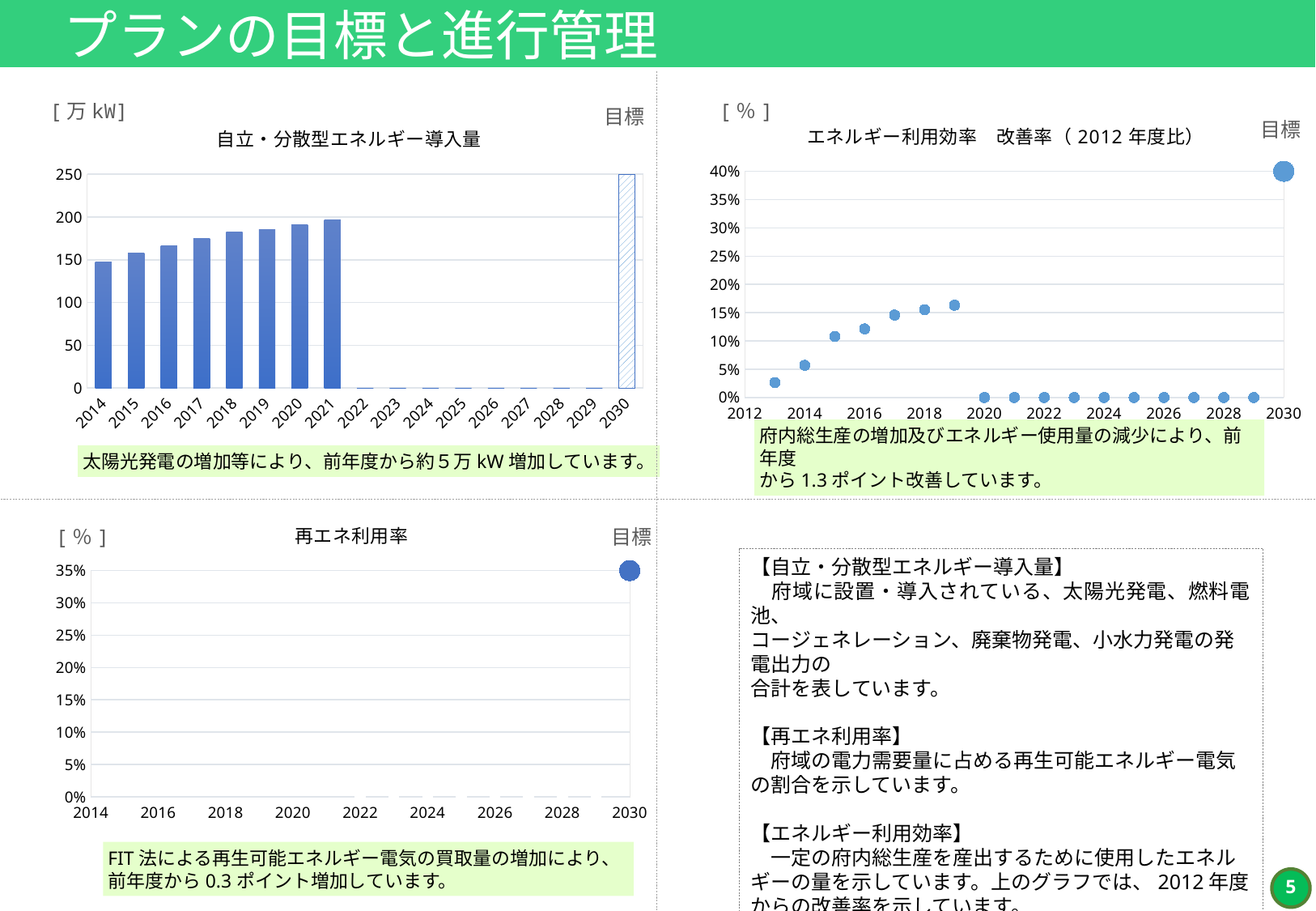
In the top-left chart 自立・分散型エネルギー導入量, do the values rise or fall from 2014 to 2021? rise In the top-left chart 自立・分散型エネルギー導入量, how many years from 2014 to 2021 have a solid data bar? 8 What kind of chart is the top-left chart titled 自立・分散型エネルギー導入量? bar chart In the top-left chart 自立・分散型エネルギー導入量, which year from 2014 to 2021 has the highest bar? 2021 In the top-right chart エネルギー利用効率 改善率（2012年度比）, what is the 目標 (target) value shown for 2030? 40% In the top-left chart 自立・分散型エネルギー導入量, is the value for 2021 greater or less than 150? greater In the top-left chart 自立・分散型エネルギー導入量, is the value for 2014 greater or less than 100? greater What unit is shown for the top-left chart 自立・分散型エネルギー導入量? 万kW In the top-left chart 自立・分散型エネルギー導入量, which year from 2014 to 2021 has the lowest bar? 2014 In the top-left chart 自立・分散型エネルギー導入量, what is the 目標 (target) value shown for 2030? 250 In the bottom-left chart 再エネ利用率, what is the 目標 (target) value shown for 2030? 35% In the top-right chart エネルギー利用効率 改善率（2012年度比）, is the value for 2019 greater or less than 15%? greater